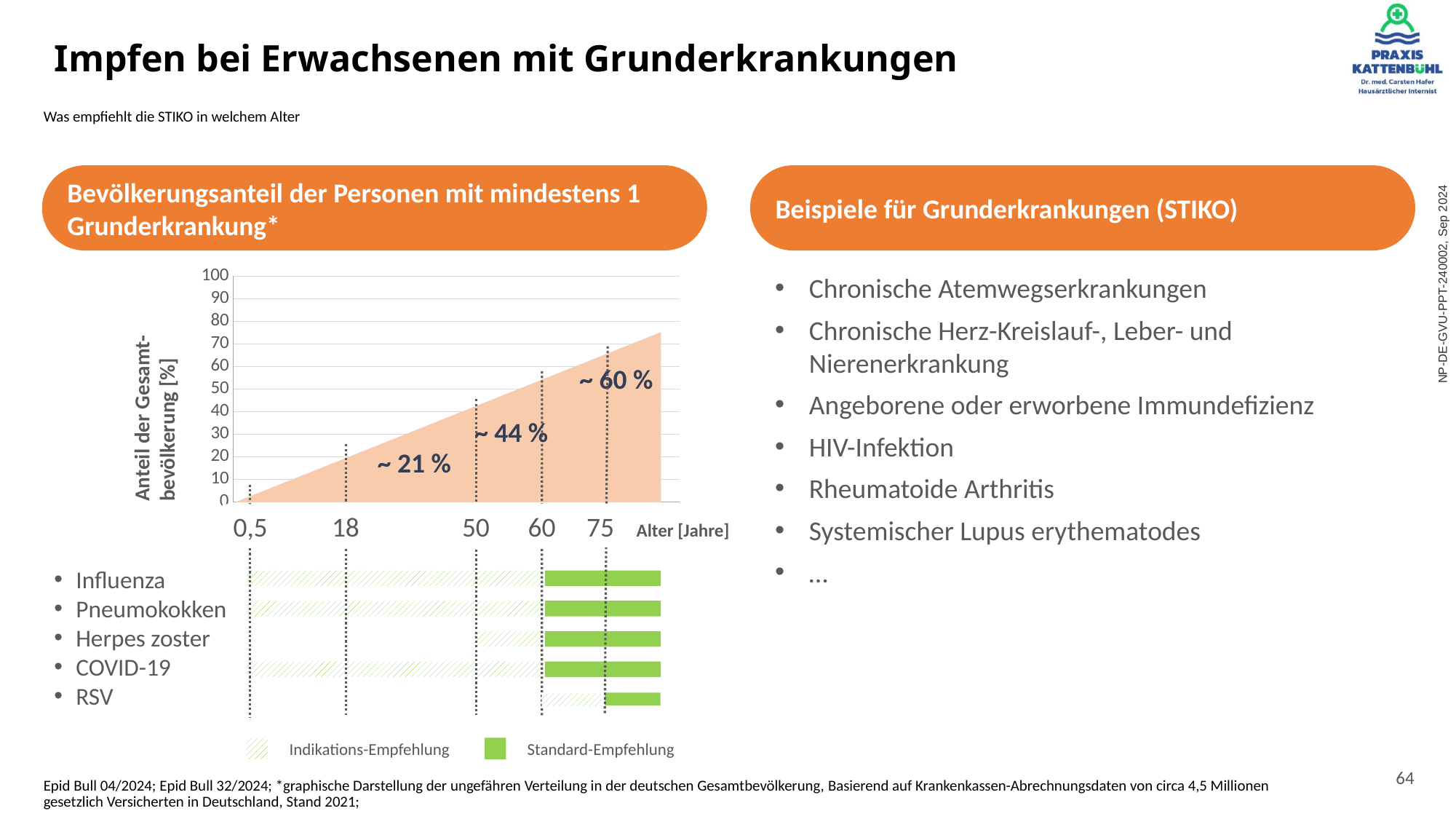
In the chart "Bevölkerungsanteil der Personen mit mindestens 1 Grunderkrankung", does the share of the population rise or fall as age increases? rises In the chart "Bevölkerungsanteil der Personen mit mindestens 1 Grunderkrankung", is the value at age 75 greater or less than 80? less In the chart "Bevölkerungsanteil der Personen mit mindestens 1 Grunderkrankung", which age has the higher share: 18 or 50? 50 In the chart "Bevölkerungsanteil der Personen mit mindestens 1 Grunderkrankung", is the value at age 50 greater or less than 30? greater Which vaccine below the chart has a Standard-Empfehlung bar starting only at age 75? RSV What kind of chart is shown under "Bevölkerungsanteil der Personen mit mindestens 1 Grunderkrankung"? area chart In the chart "Bevölkerungsanteil der Personen mit mindestens 1 Grunderkrankung", is the value at age 75 greater or less than 50? greater How many age values are marked on the x axis of the chart "Bevölkerungsanteil der Personen mit mindestens 1 Grunderkrankung"? 5 How many vaccines are listed below the chart with recommendation bars? 5 What is the y-axis label of the chart "Bevölkerungsanteil der Personen mit mindestens 1 Grunderkrankung"? Anteil der Gesamtbevölkerung [%] What are the two entries in the legend below the vaccine recommendation bars? Indikations-Empfehlung, Standard-Empfehlung